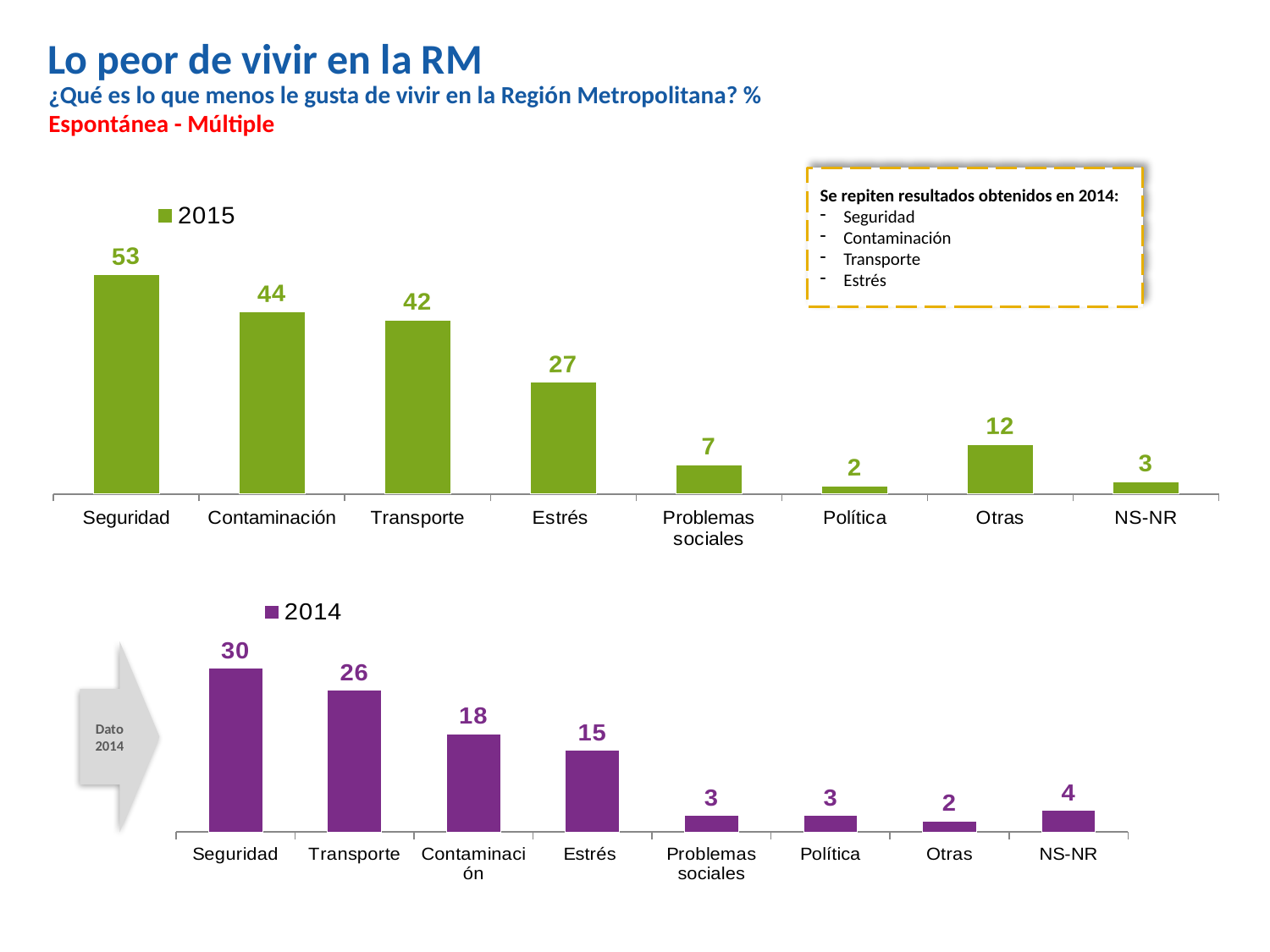
How many categories are shown in the bottom chart (2014)? 8 In the bottom chart (2014), which category has the lowest value? Otras In the bottom chart (2014), what is the value for Transporte? 26 What kind of chart is the top chart (2015)? Bar chart In the top chart (2015), what is the value for Seguridad? 53 In the bottom chart (2014), what is the difference between Seguridad and Estrés? 15 In the top chart (2015), what is the difference between Contaminación and Transporte? 2 In the top chart (2015), which category has the lowest value? Política In the bottom chart (2014), what is the value for NS-NR? 4 In the top chart (2015), which category has the highest value? Seguridad In the top chart (2015), which is larger, Otras or Problemas sociales? Otras In the top chart (2015), what is the value for Estrés? 27